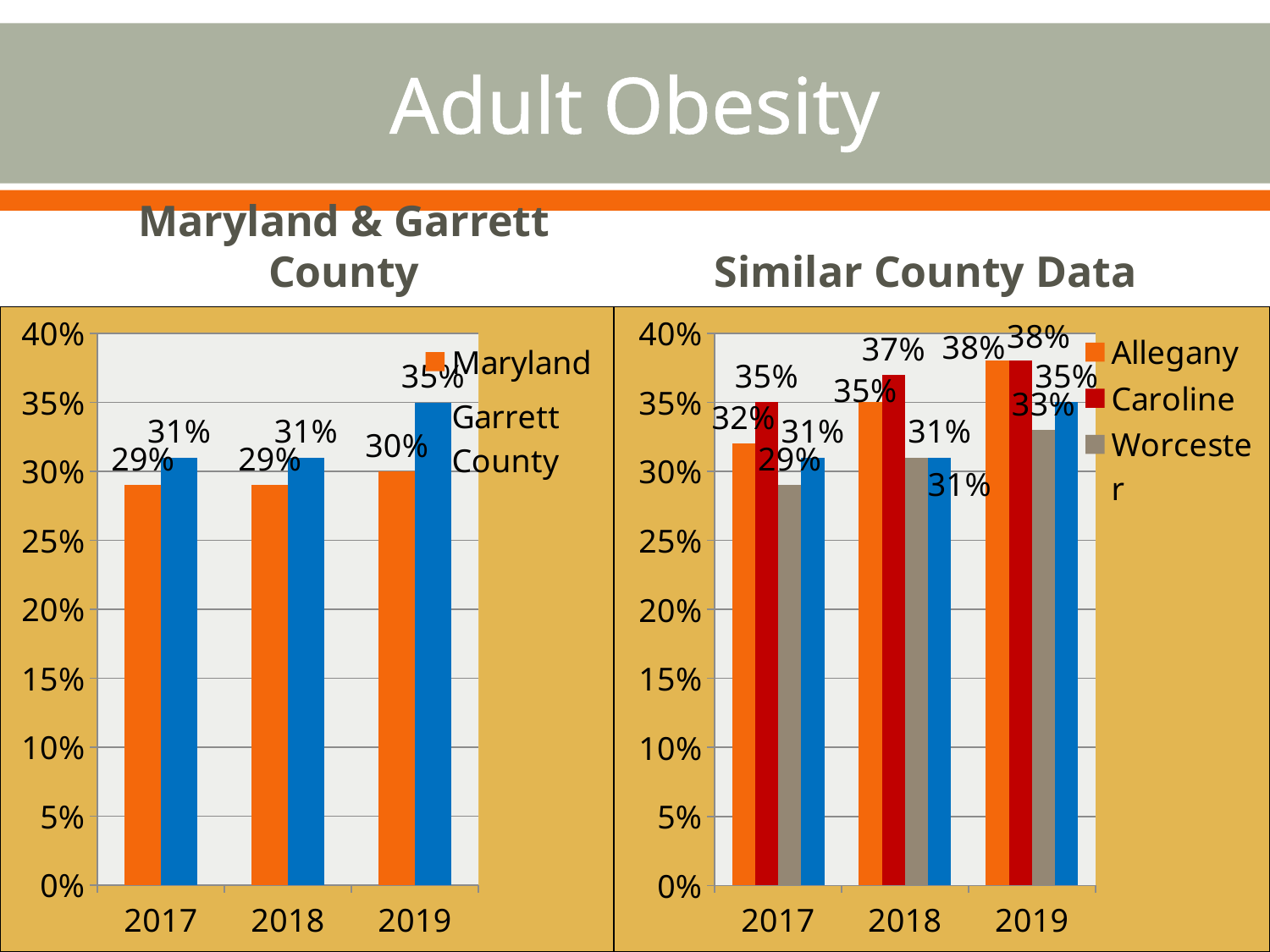
How many series does the legend of the Maryland & Garrett County chart list? 2 In the Similar County Data chart, what is the difference between the Caroline and Worcester values in 2017? 6 percentage points In the Maryland & Garrett County chart, do the Garrett County values rise or fall from 2017 to 2019? Rise In the Maryland & Garrett County chart, what is the value for Maryland in 2019? 30% In the Similar County Data chart, what is the value for Caroline in 2018? 37% In the Similar County Data chart, which of Allegany, Caroline and Worcester has the lowest value in 2018? Worcester In the Maryland & Garrett County chart, what is the value for Garrett County in 2019? 35% In the Similar County Data chart, which is larger in 2017, Allegany or Caroline? Caroline In the Similar County Data chart, what is the value for Allegany in 2019? 38% In the Similar County Data chart, what is the value for Worcester in 2017? 29% In the Maryland & Garrett County chart, what is the difference between the Garrett County and Maryland values in 2019? 5 percentage points What kind of chart is the Maryland & Garrett County chart? Bar chart